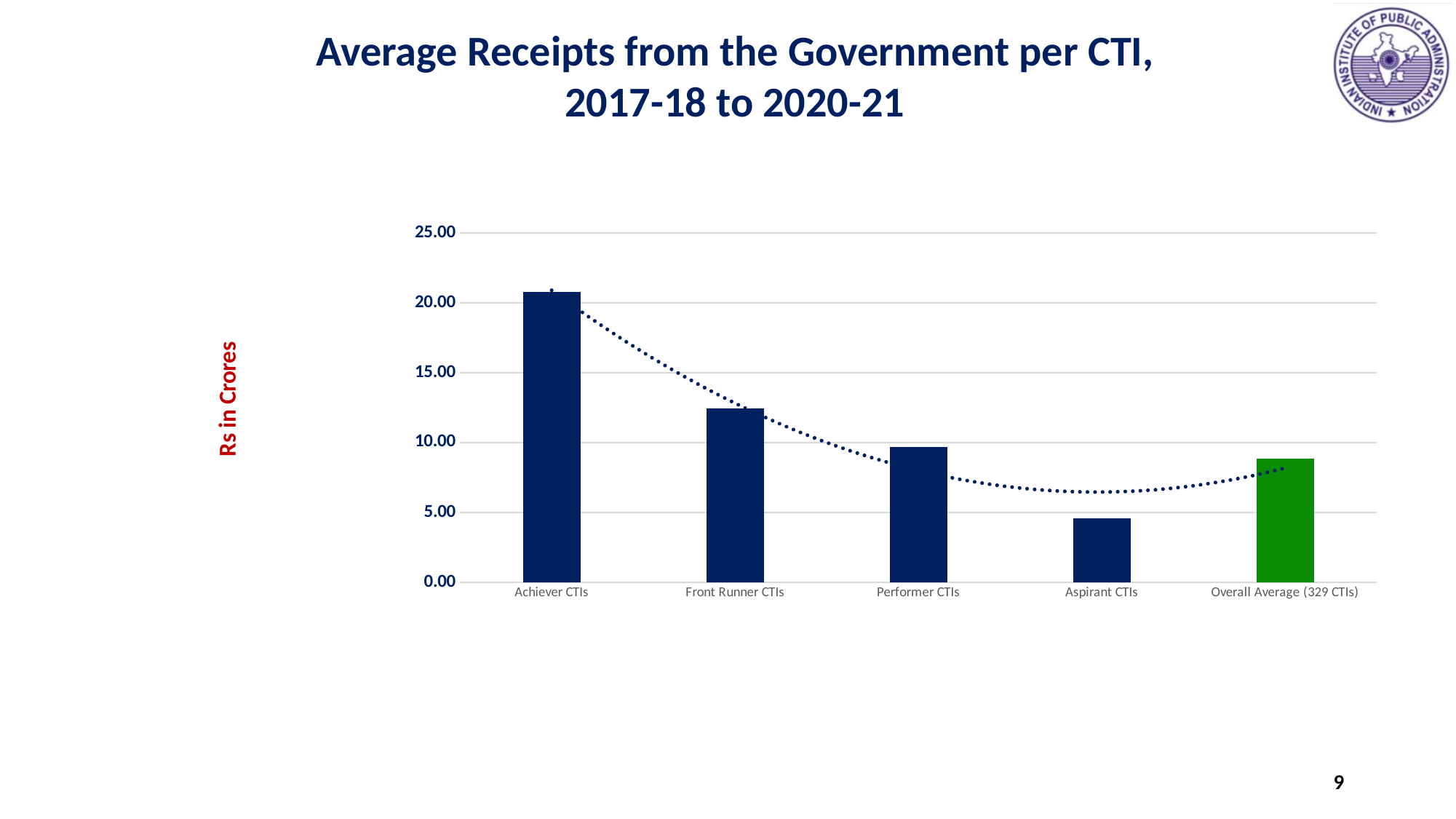
How many categories are shown on the x axis of the chart? 5 Which category has the lowest average receipts from the Government per CTI? Aspirant CTIs Which is larger, the value for Front Runner CTIs or the value for Performer CTIs? Front Runner CTIs Is the value for Aspirant CTIs greater or less than 5.00? less What kind of chart is shown on the slide? bar chart Which category has the highest average receipts from the Government per CTI? Achiever CTIs Is the value for Overall Average (329 CTIs) greater or less than 5.00? greater What is the label on the vertical axis of the chart? Rs in Crores Do the values rise or fall from Achiever CTIs to Aspirant CTIs along the x axis? fall Is the value for Achiever CTIs greater or less than 20.00? greater